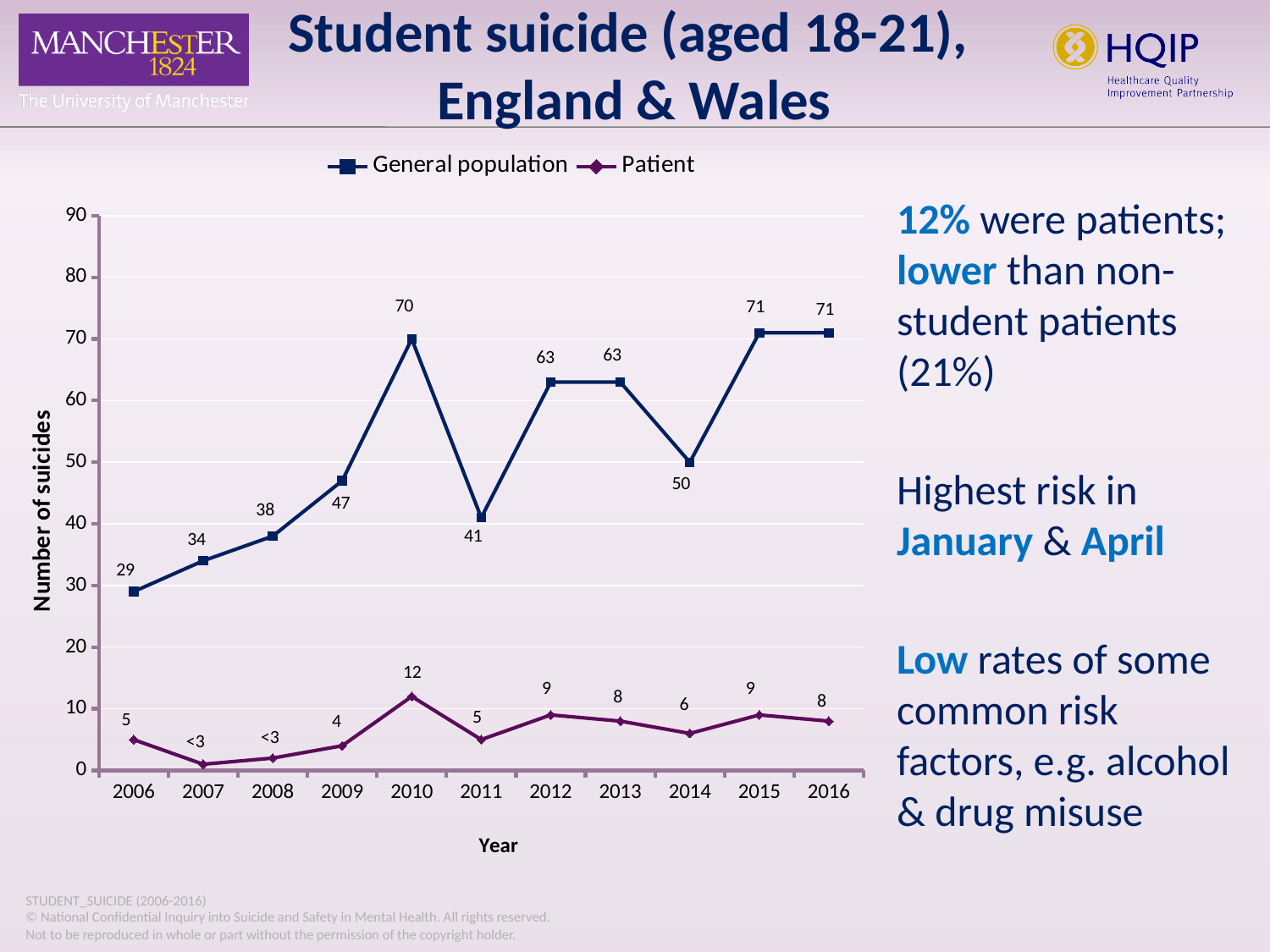
Which is larger, the General population value for 2009 or for 2014? 2014 In which year is the Patient series at its highest? 2010 What is the difference between the General population values for 2010 and 2011? 29 What is the Patient value for 2012? 9 What is the General population value for 2006? 29 How many years are shown on the x axis? 11 What is the General population value for 2010? 70 What kind of chart is shown on the slide? Line chart In which year is the General population series at its lowest? 2006 Is the General population value for 2015 greater or less than 60? greater How many series does the legend list? 2 What is the Patient value shown for 2007? <3